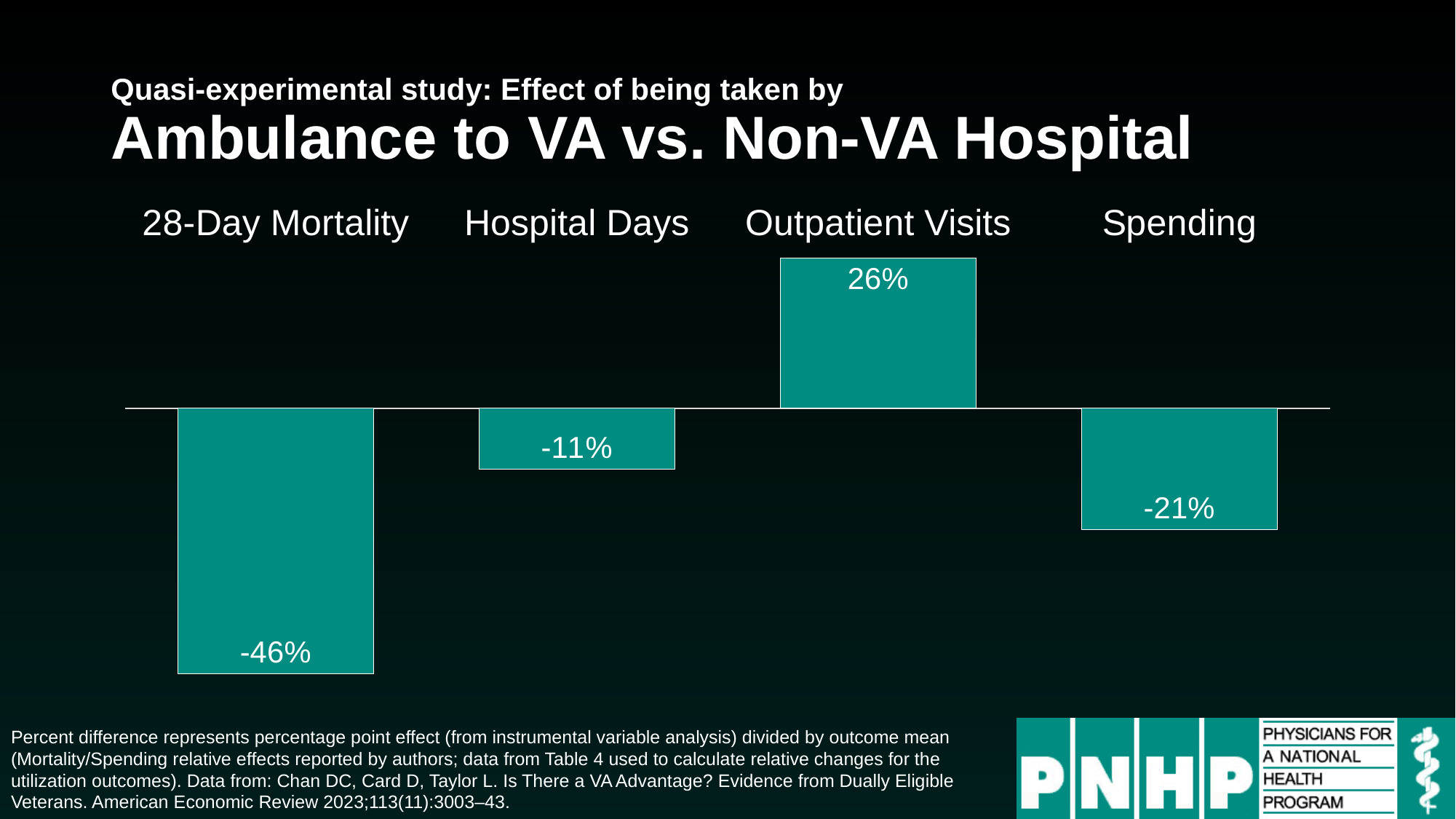
What is the value shown for Outpatient Visits? 26% Which is larger, the value for Hospital Days or the value for Spending? Hospital Days What is the value shown for 28-Day Mortality? -46% What is the difference between the values for Outpatient Visits and Spending? 47 percentage points What kind of chart is shown on the slide? Bar chart How many of the four categories have a negative value? 3 How many categories are shown in the chart? 4 What is the difference between the values for Hospital Days and 28-Day Mortality? 35 percentage points Which category has the lowest value? 28-Day Mortality What is the value shown for Spending? -21% Which category has the highest value? Outpatient Visits What is the value shown for Hospital Days? -11%